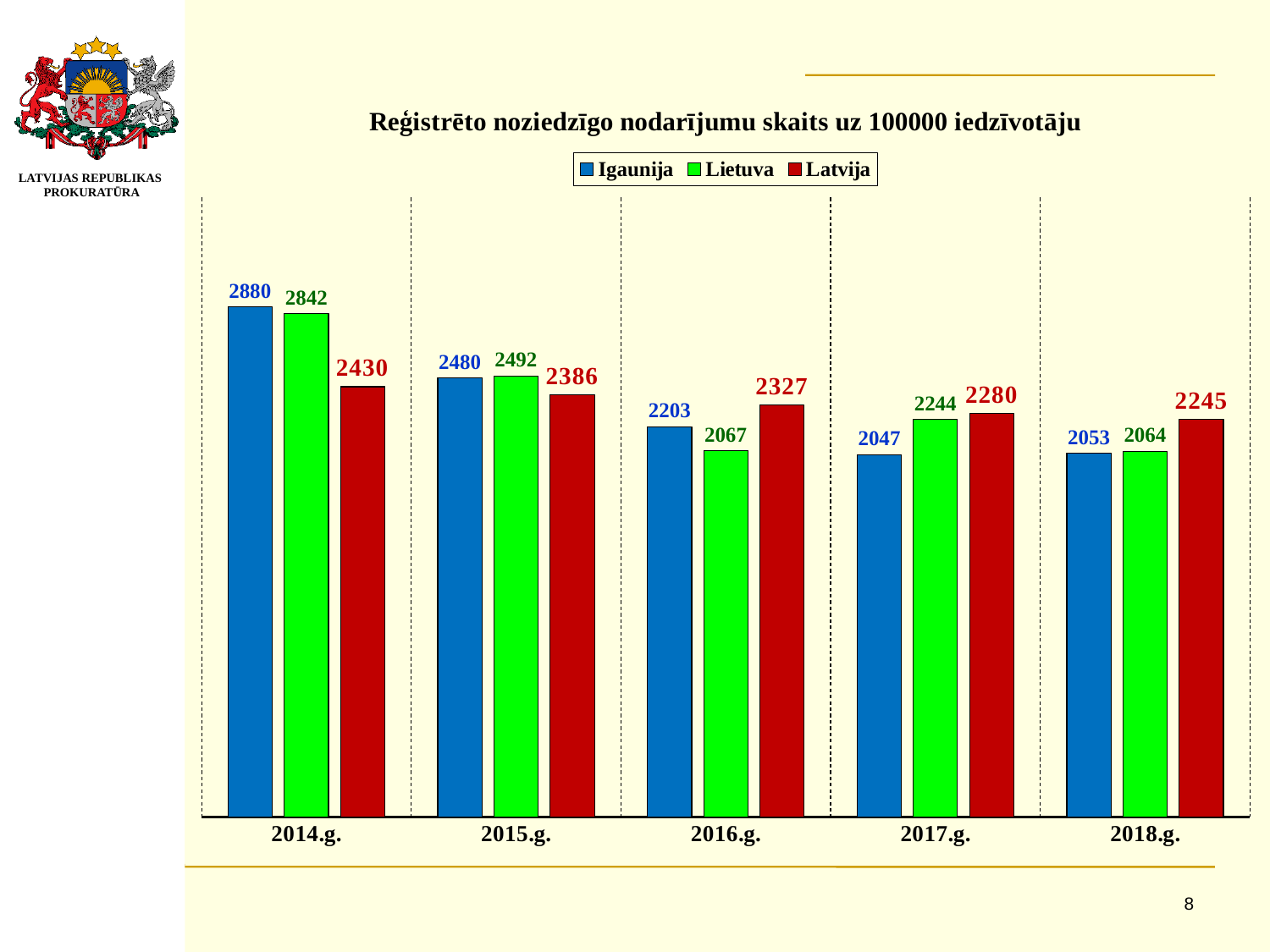
What is the difference between the Igaunija and Latvija values in 2014.g.? 450 What is the value for Latvija in 2016.g.? 2327 What is the value for Igaunija in 2014.g.? 2880 Which year has the highest value for Latvija? 2014.g. How many series does the legend list? 3 What kind of chart is shown on the slide? bar chart Which year has the lowest value for Igaunija? 2017.g. What is the value for Lietuva in 2018.g.? 2064 What is the difference between the Latvija and Lietuva values in 2016.g.? 260 Which is larger in 2017.g., Lietuva or Latvija? Latvija Does the value for Igaunija rise or fall from 2014.g. to 2017.g.? fall How many years are shown on the x axis? 5